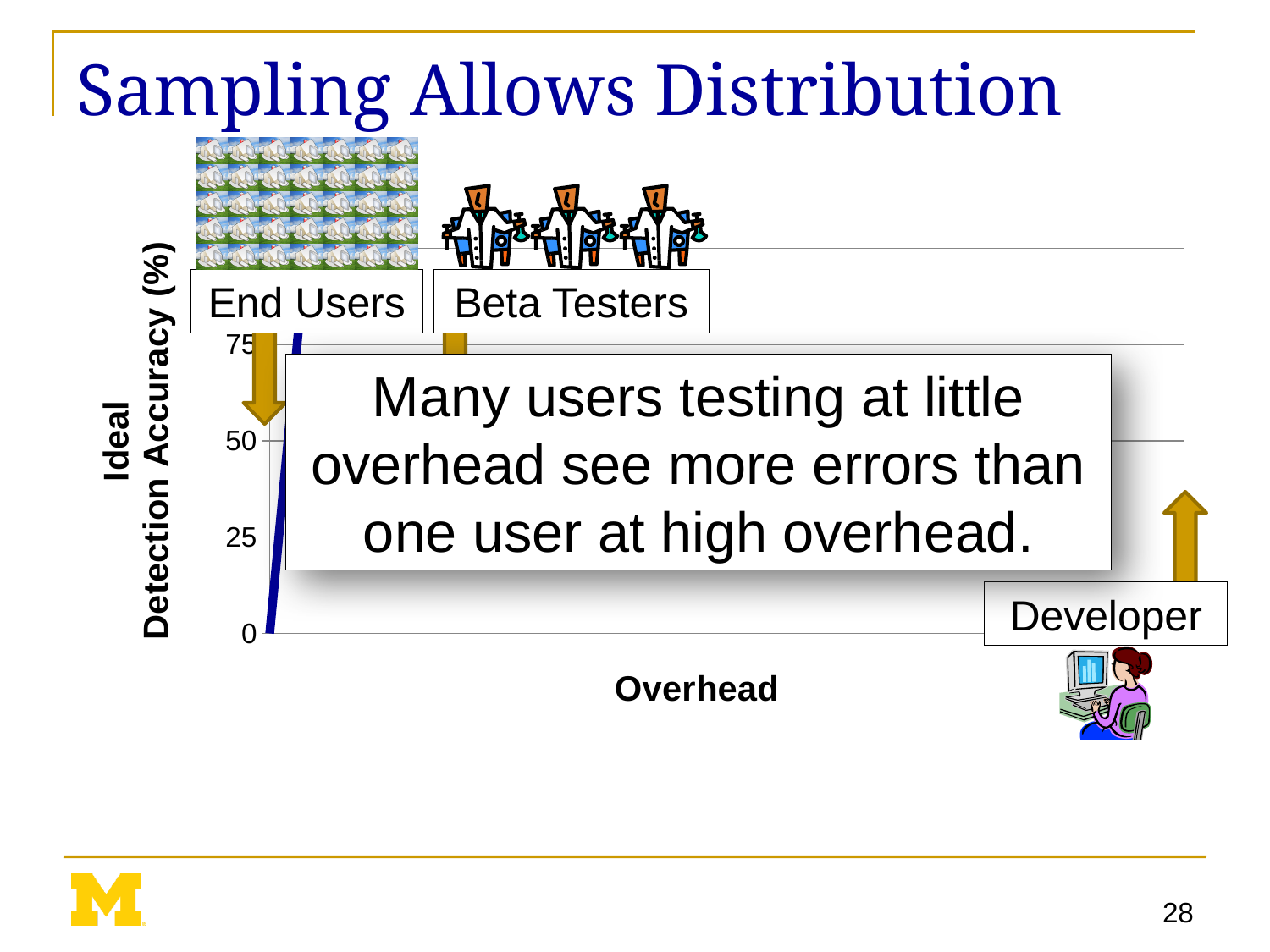
What kind of chart is shown on the slide? line chart What is the title of the horizontal axis of the chart? Overhead What is the title of the vertical axis of the chart? Ideal Detection Accuracy (%) Does the plotted line rise or fall as overhead increases along the x axis? rise